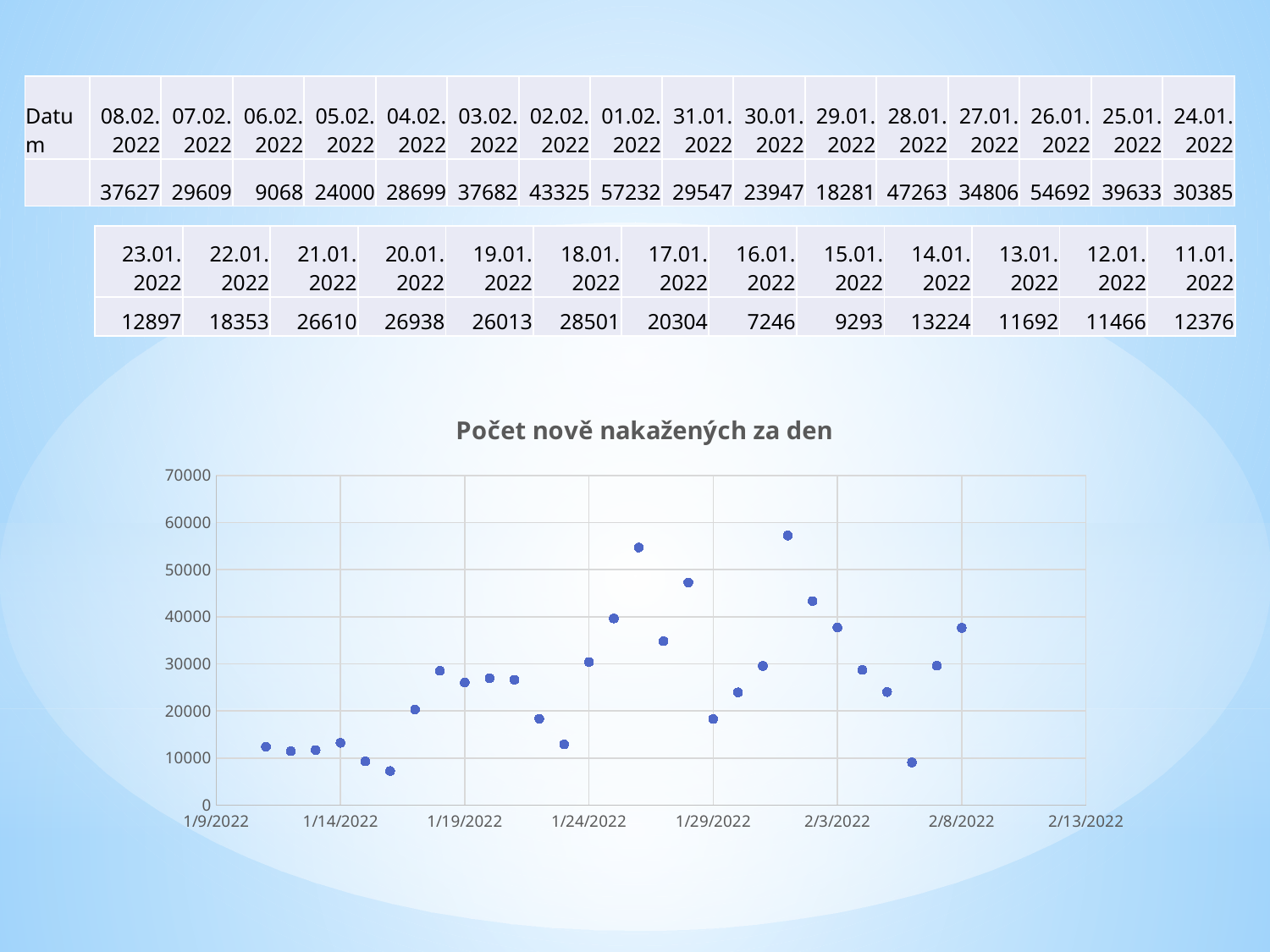
Is the plotted value for 1/19/2022 greater or less than 20000? greater On which date does the chart reach its highest value? 01.02.2022 What kind of chart is shown on the slide? scatter chart Which is larger, the plotted value for 1/26/2022 or for 1/27/2022? 1/26/2022 According to the table above the chart, what is the number of newly infected on 01.02.2022? 57232 Is the plotted value for 2/1/2022 greater or less than 50000? greater What is the title of the chart? Počet nově nakažených za den Do the plotted values rise or fall from 1/16/2022 to 1/18/2022? rise Is the plotted value for 1/16/2022 greater or less than 10000? less How many data points are plotted in the chart? 29 On which date does the chart show its lowest value? 16.01.2022